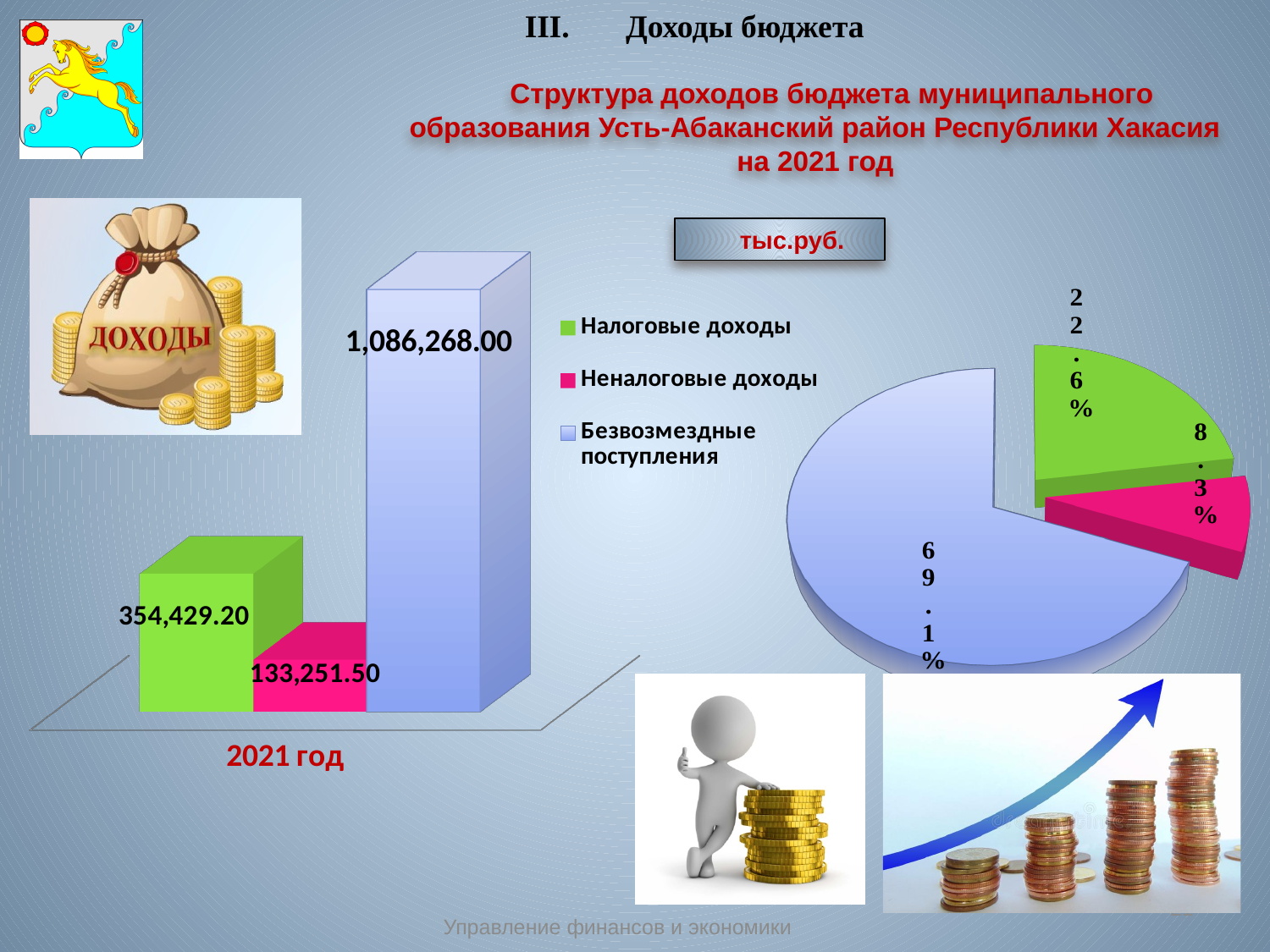
What type of chart is shown on the left side of the slide? Bar chart In the pie chart on the right, what share is shown for Налоговые доходы (green slice)? 22.6% In the bar chart on the left, what is the difference between Налоговые доходы and Неналоговые доходы? 221,177.70 In the bar chart on the left, what is the value for Неналоговые доходы? 133,251.50 In the bar chart on the left, what is the value for Безвозмездные поступления? 1,086,268.00 In the bar chart on the left, how many bars are plotted? 3 In the bar chart on the left, what is the value for Налоговые доходы? 354,429.20 In the bar chart on the left, which category has the highest value? Безвозмездные поступления How many entries does the legend list? 3 In the pie chart on the right, what share is shown for Безвозмездные поступления (blue slice)? 69.1% In the bar chart on the left, which is larger: Налоговые доходы or Неналоговые доходы? Налоговые доходы In the bar chart on the left, which category has the lowest value? Неналоговые доходы